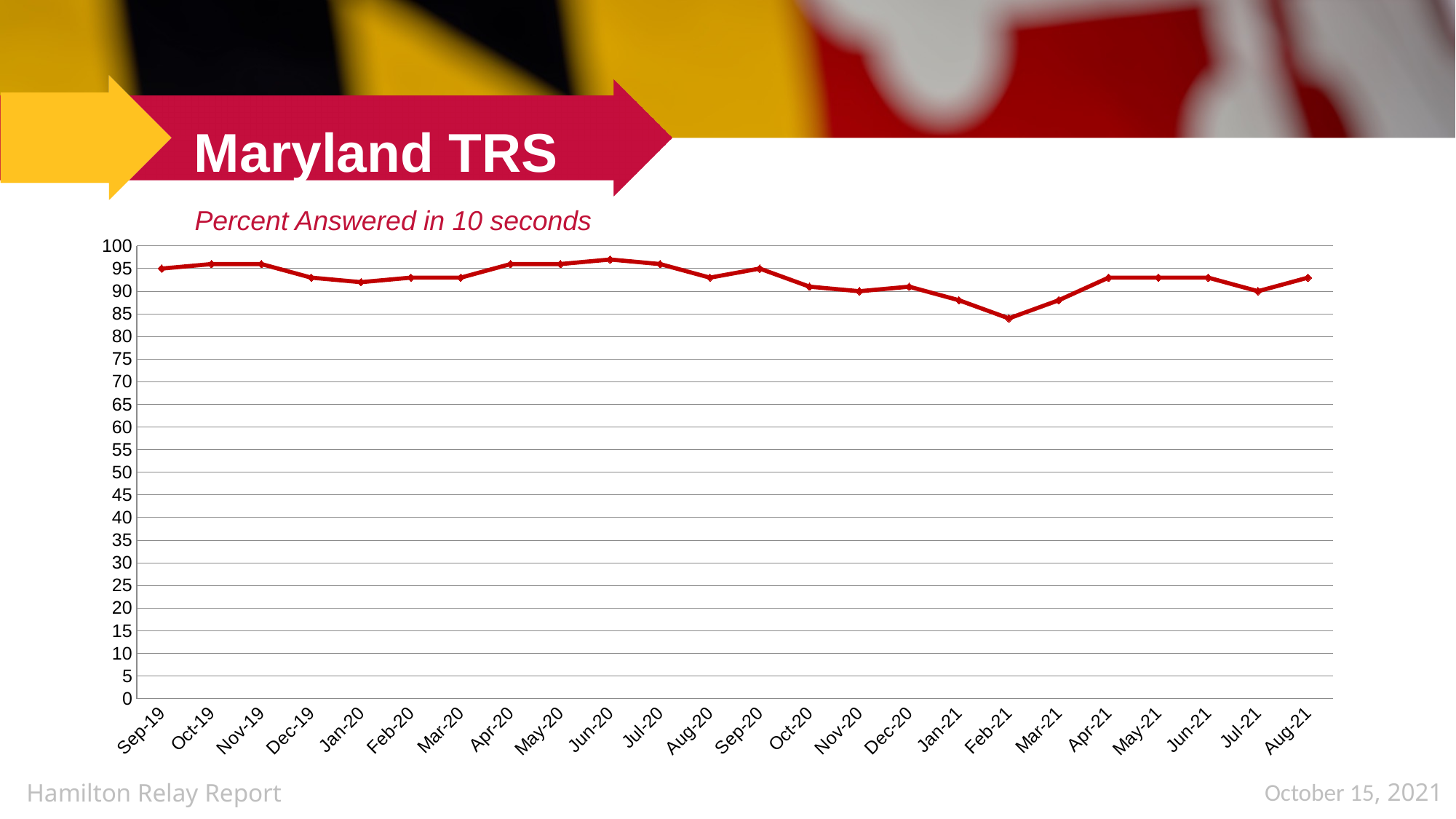
Is the value for Jan-21 greater or less than 90? less What colour is the plotted line? red Is the value for Feb-21 greater or less than 90? less Which is larger, the value for Jun-20 or the value for Feb-21? Jun-20 Is the value for Jun-20 greater or less than 95? greater What kind of chart is shown on the slide? line chart How many monthly data points are plotted on the chart? 24 Which is larger, the value for Oct-19 or the value for Jan-21? Oct-19 What is the title of the chart? Percent Answered in 10 seconds Which month has the lowest percent answered in 10 seconds? Feb-21 Do the values rise or fall from Dec-20 to Feb-21? fall